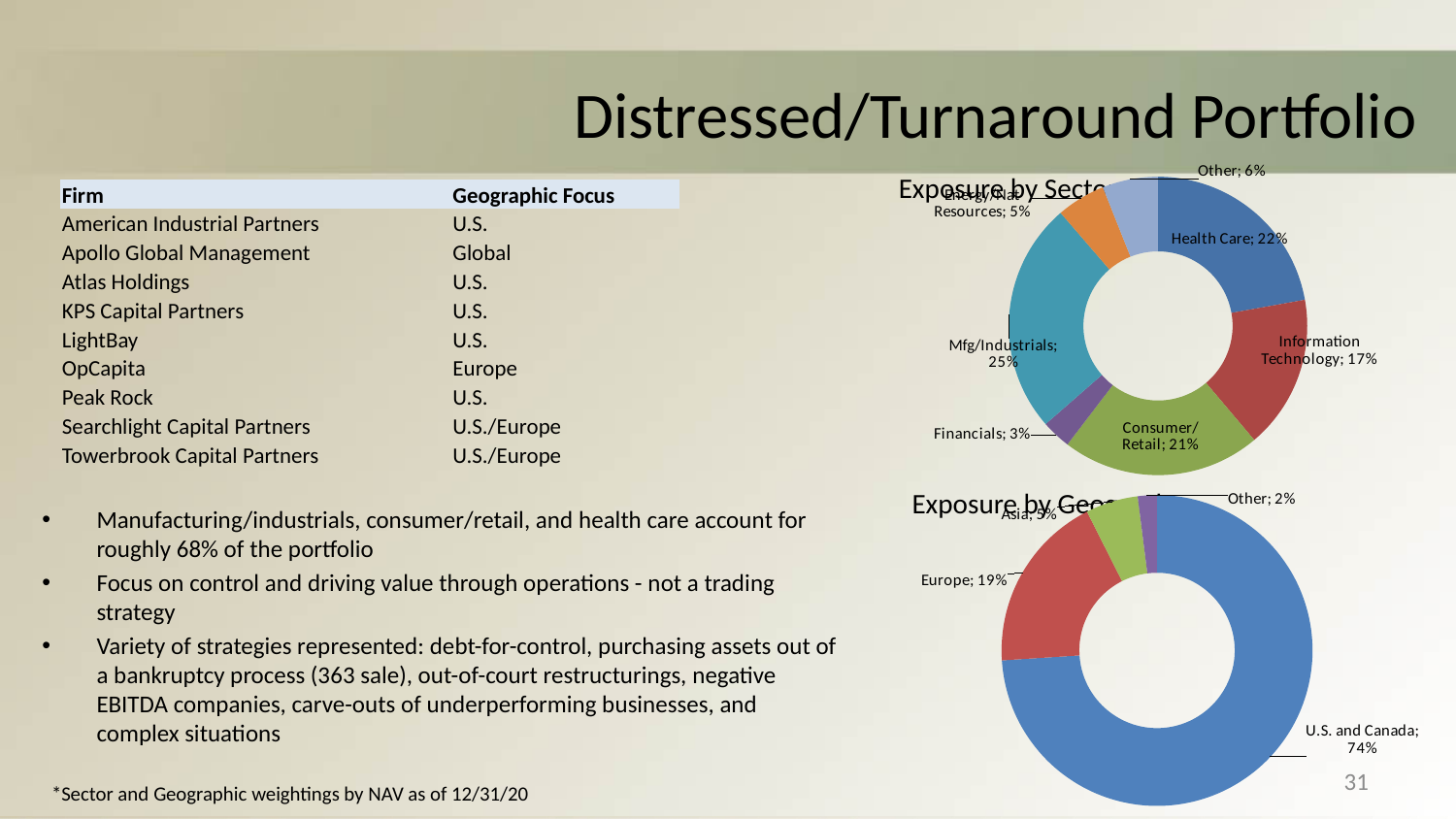
In the bottom chart (Exposure by Geography), what is the value for U.S. and Canada? 74% In the bottom chart (Exposure by Geography), what is the value for Europe? 19% In the top chart (Exposure by Sector), what is the value for Mfg/Industrials? 25% In the top chart (Exposure by Sector), which sector has the largest share? Mfg/Industrials In the bottom chart (Exposure by Geography), which region has the smallest share? Other What type of chart is the top chart (Exposure by Sector)? Doughnut chart In the top chart (Exposure by Sector), which is larger, Consumer/Retail or Information Technology? Consumer/Retail How many sector categories are shown in the top chart (Exposure by Sector)? 7 How many regions are shown in the bottom chart (Exposure by Geography)? 4 In the top chart (Exposure by Sector), what is the value for Health Care? 22% In the top chart (Exposure by Sector), what is the difference between Health Care and Information Technology? 5% In the top chart (Exposure by Sector), which sector has the smallest share? Financials